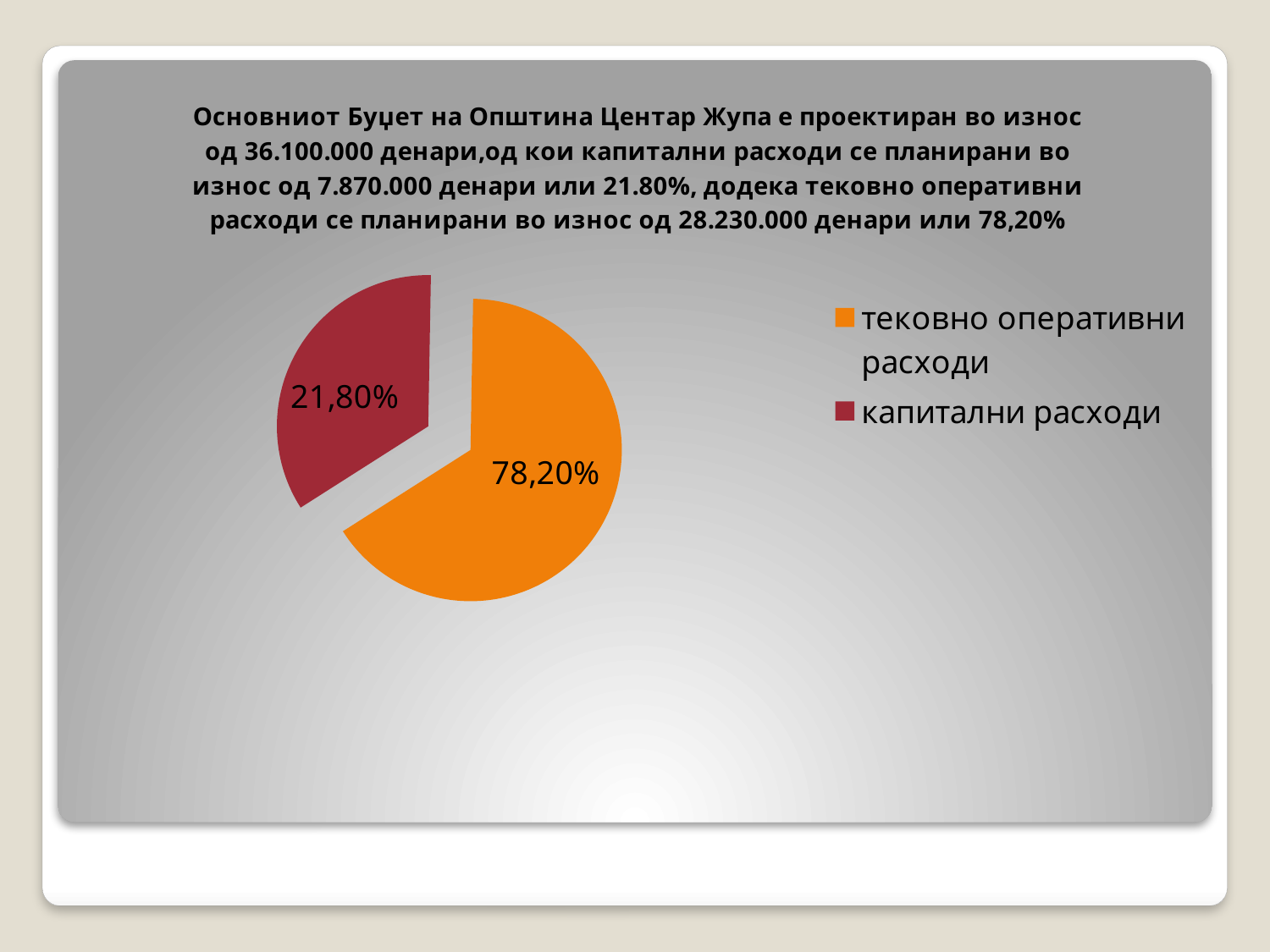
What is the difference in percentage points between the slice for тековно оперативни расходи and the slice for капитални расходи? 56,40% What share of the pie does the slice for капитални расходи represent? 21,80% How many slices does the pie chart have? 2 What kind of chart is shown on the slide? pie chart What colour is the slice for тековно оперативни расходи? orange Which is larger, the slice for тековно оперативни расходи or the slice for капитални расходи? тековно оперативни расходи Which category has the smallest slice of the pie? капитални расходи What colour is the slice for капитални расходи? dark red Which category has the largest slice of the pie? тековно оперативни расходи How many entries does the legend list? 2 What share of the pie does the slice for тековно оперативни расходи represent? 78,20%